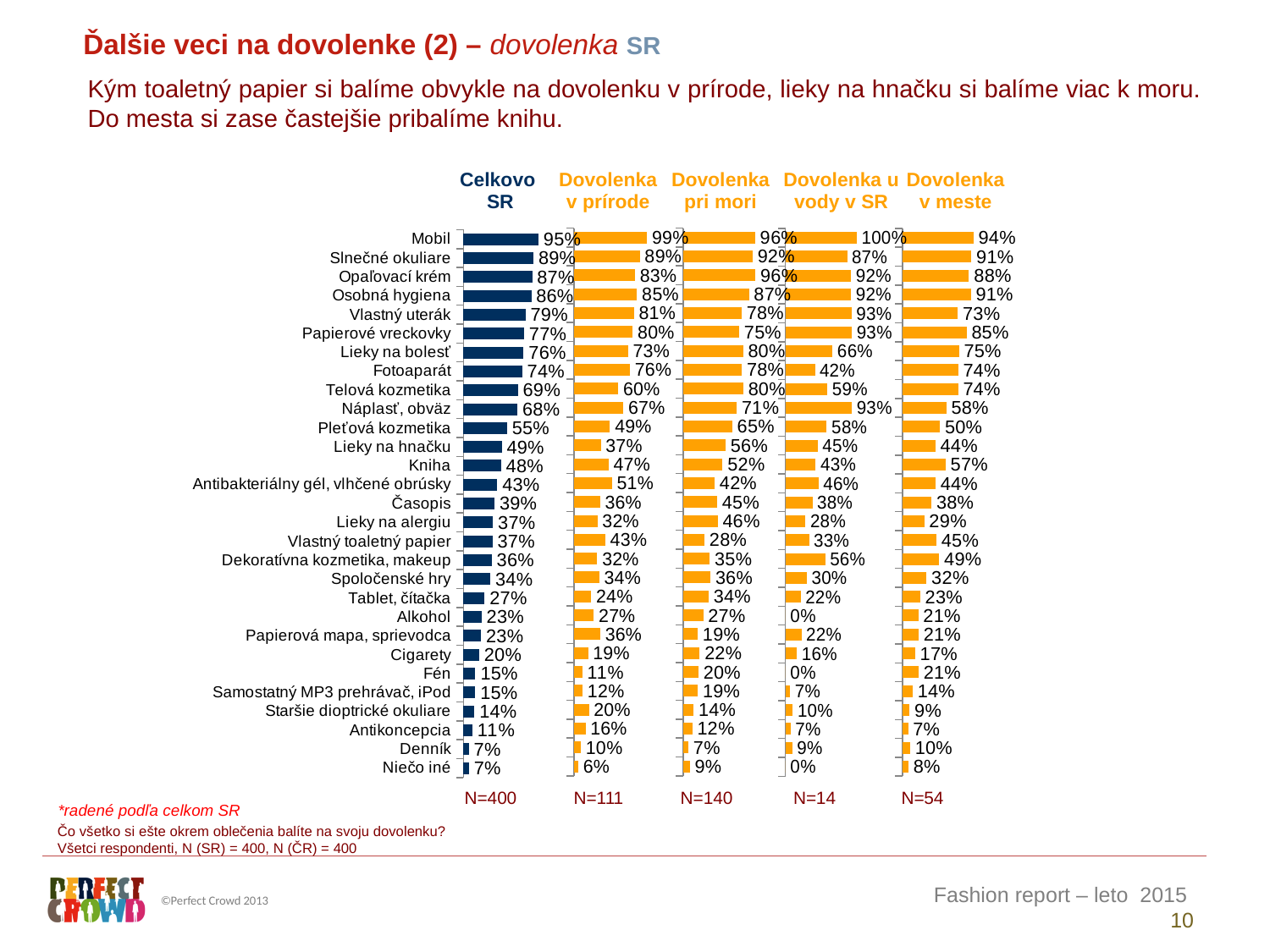
In the 'Celkovo SR' chart, what is the value for Mobil? 95% What type of chart is used on this slide? Bar chart In the 'Dovolenka pri mori' chart, what is the value for Lieky na hnačku? 56% In the 'Dovolenka pri mori' chart, which category has the lowest value? Denník In the 'Dovolenka u vody v SR' chart, what is the value for Fotoaparát? 42% In the 'Dovolenka v prírode' chart, which category has the highest value? Mobil In the 'Celkovo SR' chart, what is the difference between Slnečné okuliare and Opaľovací krém? 2% In the 'Dovolenka v meste' chart, what is the value for Kniha? 57% In the 'Dovolenka v meste' chart, which is larger: Dekoratívna kozmetika, makeup or Spoločenské hry? Dekoratívna kozmetika, makeup What is the sample size (N) shown under the 'Dovolenka pri mori' chart? N=140 How many categories are listed in the 'Celkovo SR' chart? 29 In the 'Dovolenka v prírode' chart, what is the difference between Vlastný toaletný papier and Lieky na hnačku? 6%